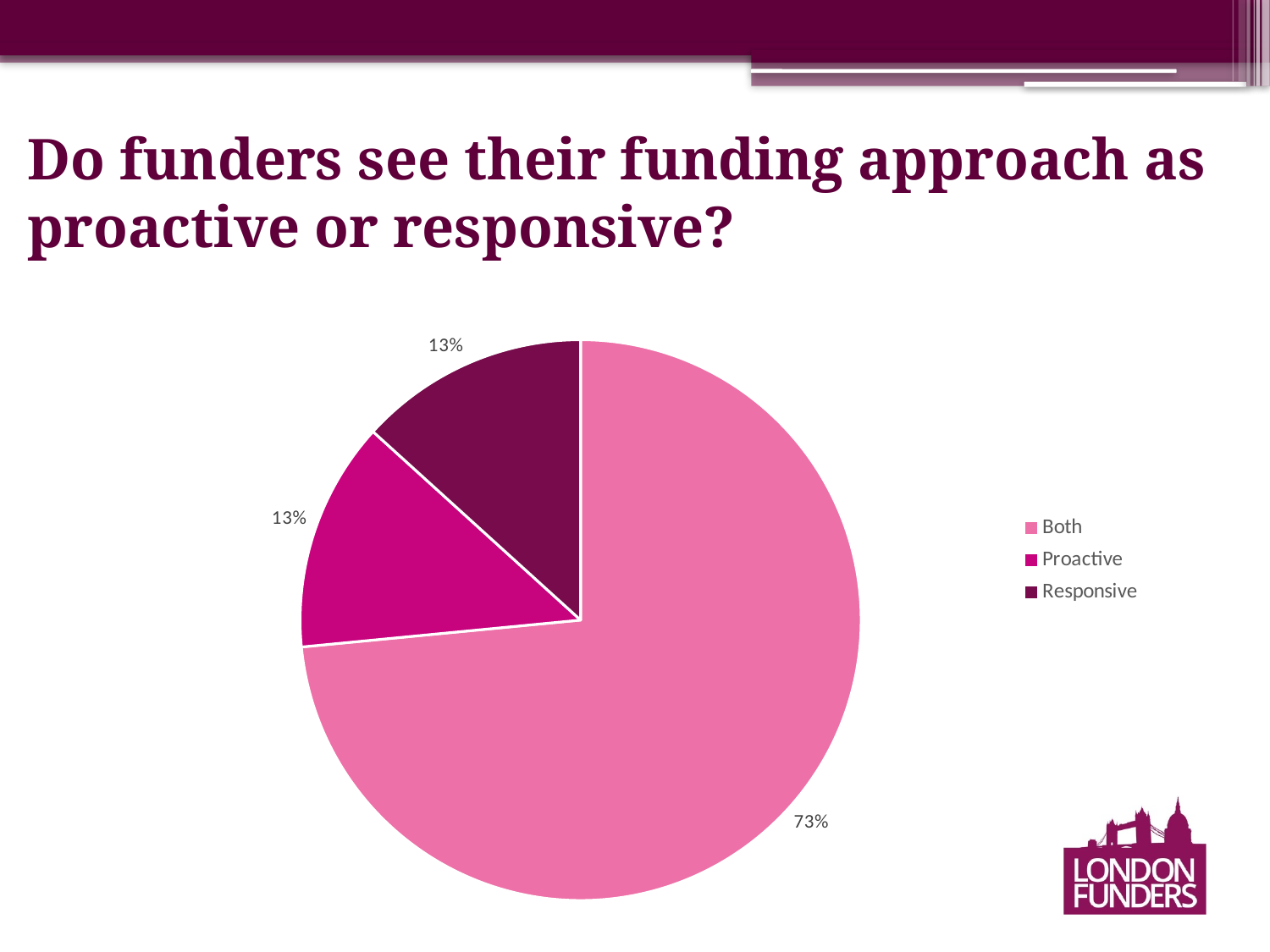
Which is larger, the "Both" slice or the "Responsive" slice? Both What kind of chart is shown on the slide? pie chart What is the difference in percentage points between the "Both" slice and the "Proactive" slice? 60 How many slices does the pie chart have? 3 What is the title of the slide containing the pie chart? Do funders see their funding approach as proactive or responsive? Which category has the largest slice of the pie? Both What share of the pie is labelled "Proactive"? 13% How many entries does the legend list? 3 Which legend entry is shown in the darkest colour? Responsive What share of the pie is labelled "Both"? 73% Is the share for "Both" greater or less than 50%? greater What share of the pie is labelled "Responsive"? 13%